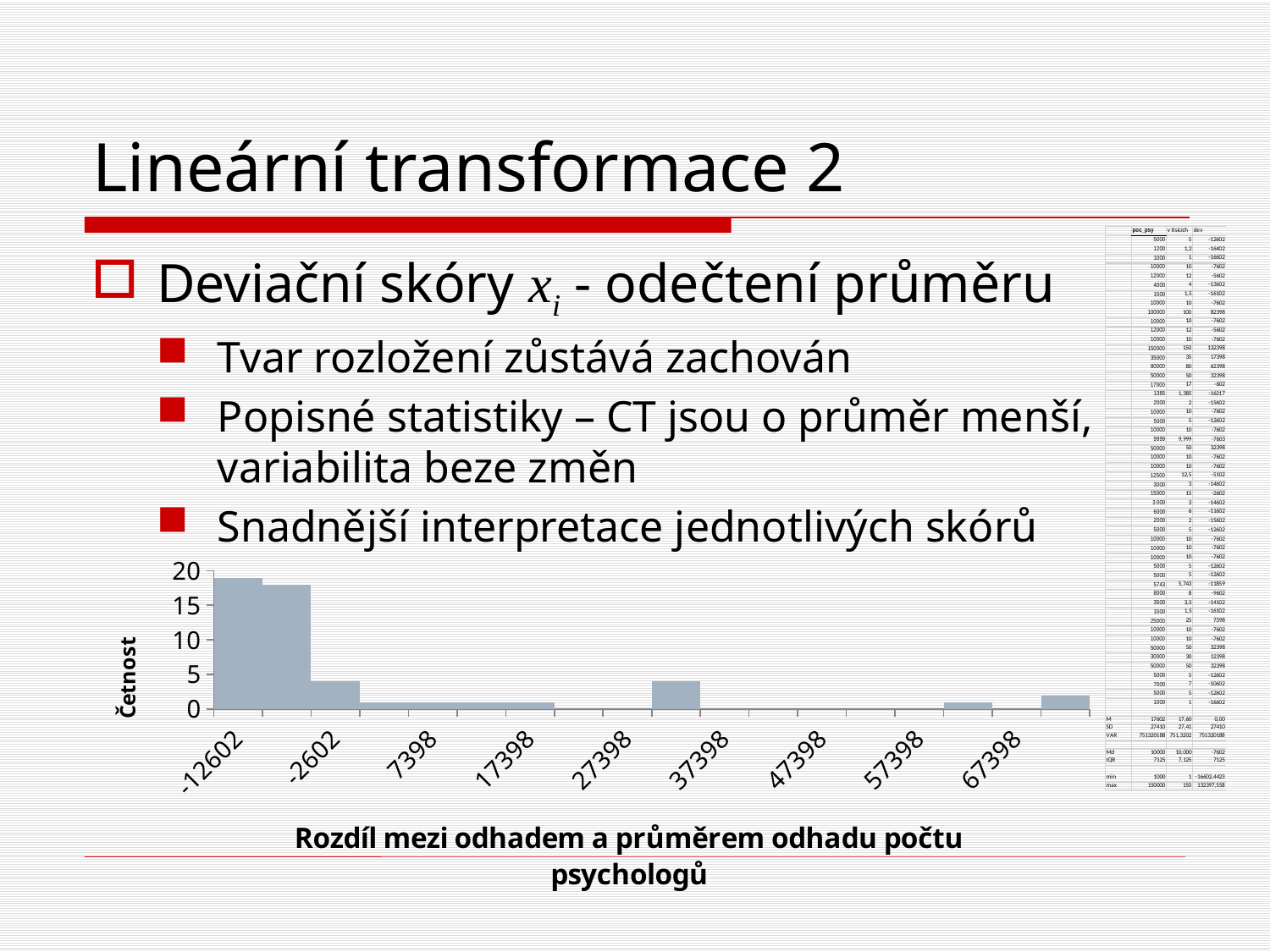
Which horizontal-axis label is the tallest bar located at? -12602 Is the value of the bar at the 7398 tick greater or less than 5? less What is the title of the vertical axis of the chart? Četnost How many labels are printed on the horizontal axis of the chart? 9 What is the title of the horizontal axis of the chart? Rozdíl mezi odhadem a průměrem odhadu počtu psychologů What is the lowest label shown on the horizontal axis? -12602 What kind of chart is shown on the slide? bar chart Is the value of the rightmost bar (at 67398) greater or less than 5? less Which is larger: the leftmost bar (at -12602) or the rightmost bar (at 67398)? the leftmost bar (at -12602) Is the tallest bar in the right half of the chart (near 37398) greater or less than 10? less Do the bar heights generally rise or fall from left to right along the horizontal axis? fall